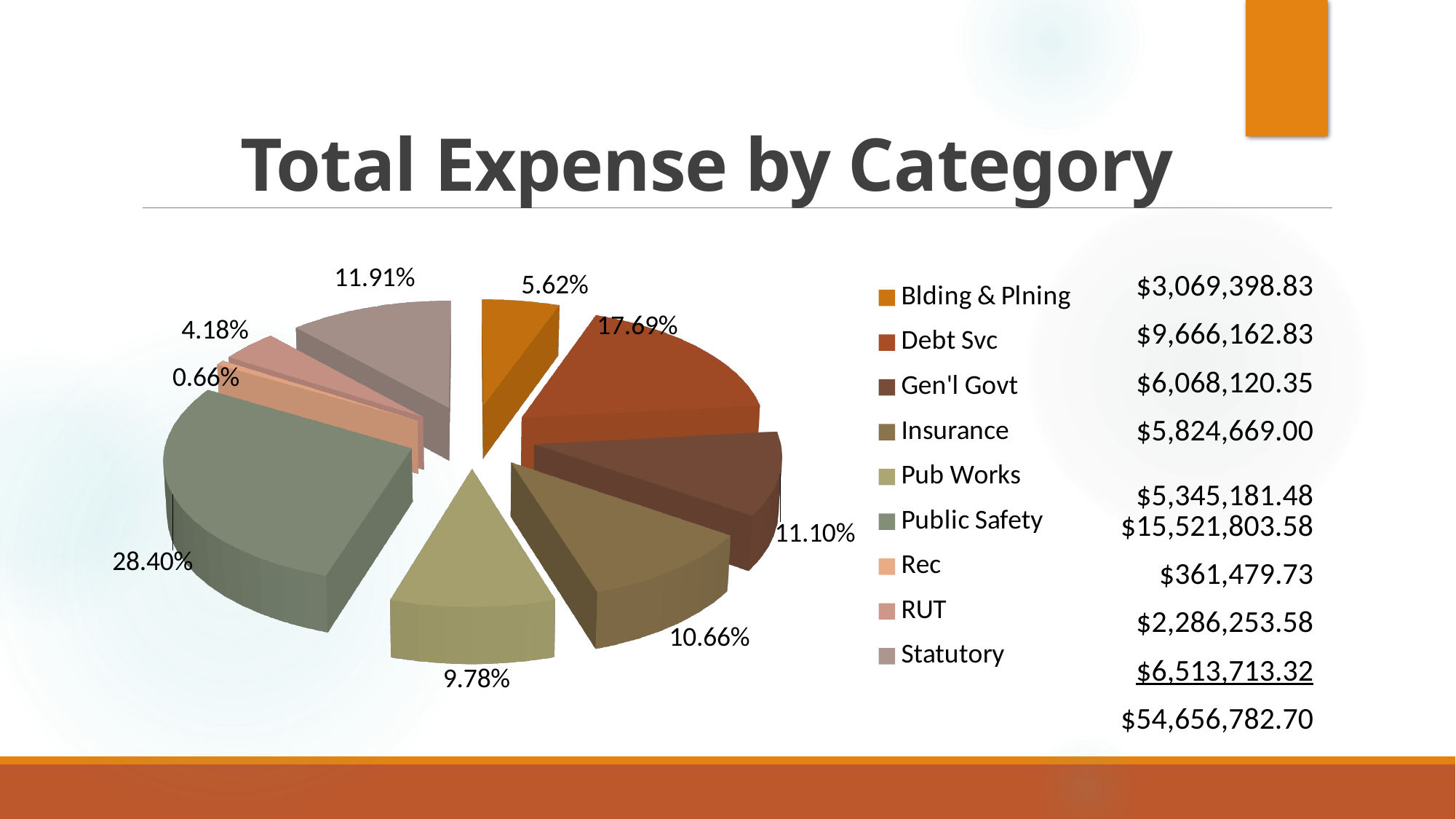
Which category has the smallest slice of the pie? Rec What is the title of the chart? Total Expense by Category What share of the pie does Rec represent? 0.66% Which category has the largest slice of the pie? Public Safety How many categories does the legend list? 9 What kind of chart is shown on the slide? pie chart What share of the pie does Debt Svc represent? 17.69% What share of the pie does Public Safety represent? 28.40% What colour is the Blding & Plning slice? orange Which is larger, the share for Gen'l Govt or the share for Pub Works? Gen'l Govt What is the difference in percentage points between the Public Safety share and the Debt Svc share? 10.71